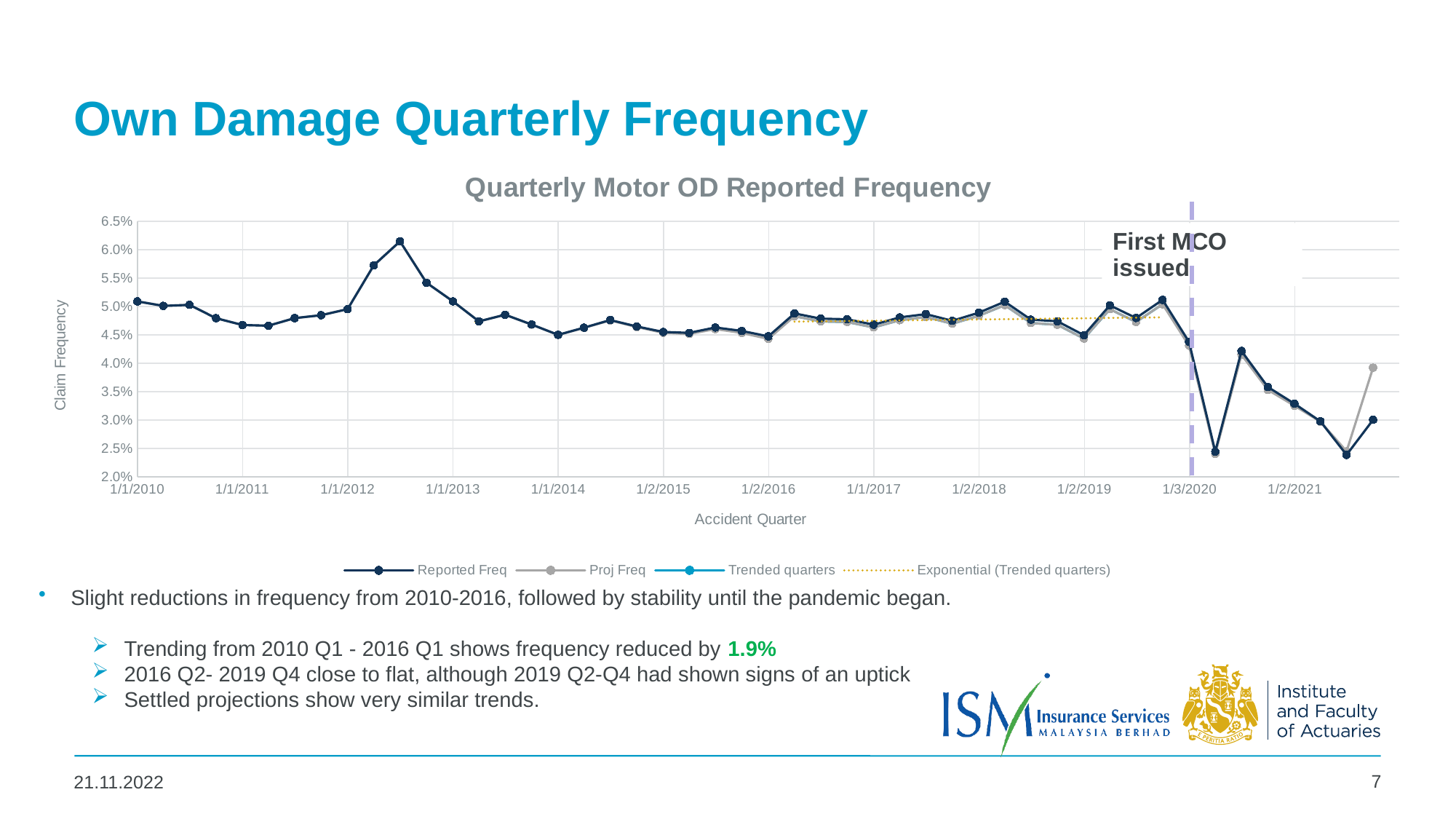
How many series does the chart legend list? 4 In which year does the Reported Freq series reach its highest value? 2012 Does the Reported Freq series generally rise or fall between 1/1/2010 and 1/1/2011? Fall Which is larger, the Reported Freq value at 1/1/2010 or at 1/1/2014? 1/1/2010 Which is larger, the Reported Freq value at 1/2/2019 or at 1/2/2021? 1/2/2019 Is the Reported Freq value at 1/1/2011 greater or less than 5.0%? less Is the Reported Freq value at 1/2/2021 greater or less than 3.5%? less Is the Reported Freq value at 1/3/2020 greater or less than 4.5%? less What is the label of the vertical axis of the chart? Claim Frequency What kind of chart is shown on the slide? Line chart What is the title of the chart? Quarterly Motor OD Reported Frequency